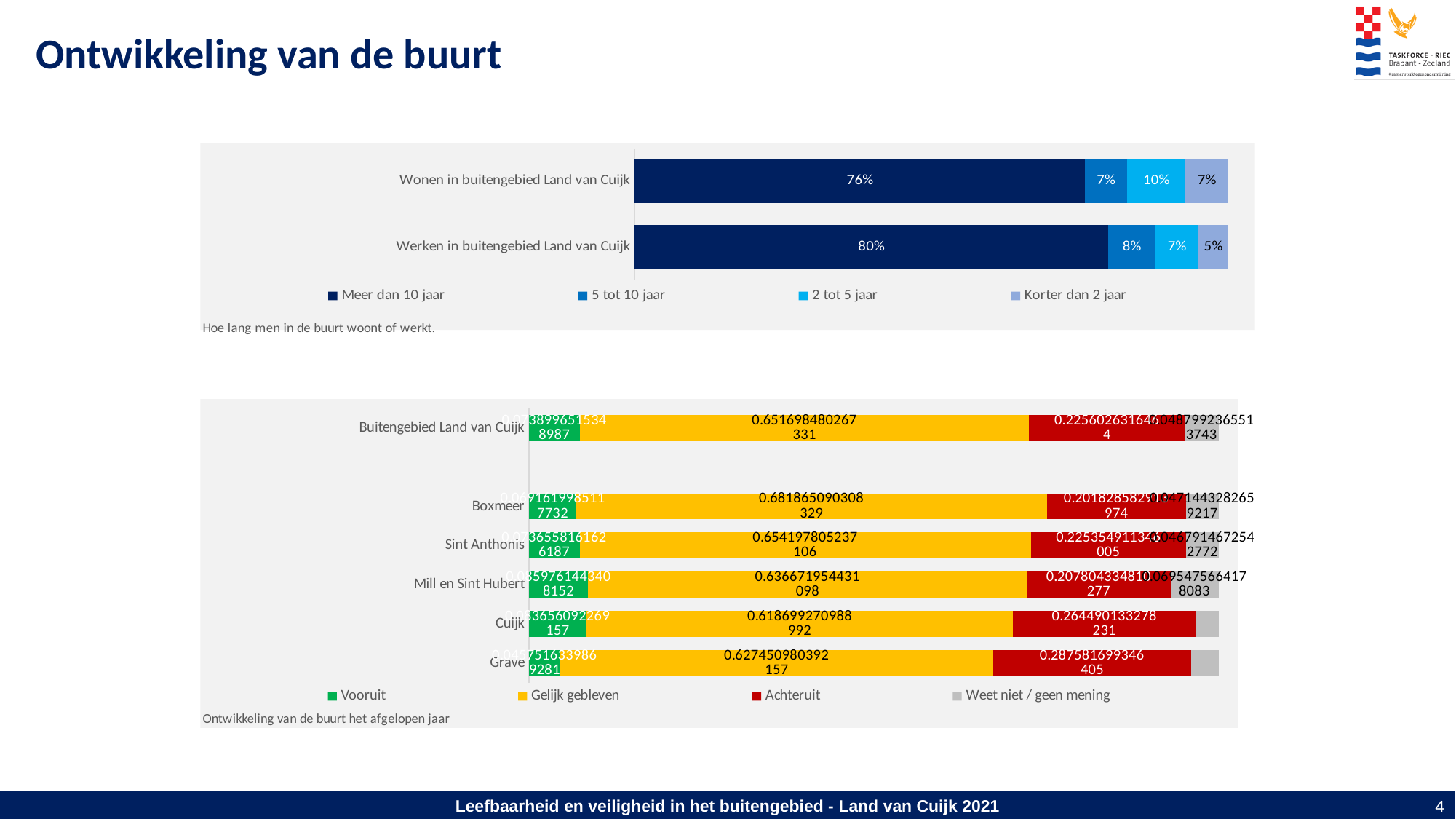
How many categories are shown in the bottom chart ('Ontwikkeling van de buurt het afgelopen jaar')? 6 In the top chart, what is the difference between the 'Meer dan 10 jaar' values for Werken and Wonen in buitengebied Land van Cuijk? 4% In the bottom chart, which series is shown in yellow according to the legend? Gelijk gebleven In the bottom chart, which category has the largest 'Achteruit' (red) segment? Grave How many series does the legend of the top chart list? 4 In the top chart, what is the 'Meer dan 10 jaar' value for 'Werken in buitengebied Land van Cuijk'? 80% In the top chart, what is the 'Korter dan 2 jaar' value for 'Werken in buitengebied Land van Cuijk'? 5% In the top chart, what is the '2 tot 5 jaar' value for 'Wonen in buitengebied Land van Cuijk'? 10% What type of chart is the top chart on the slide? Stacked bar chart In the top chart, what is the difference between the '2 tot 5 jaar' values for Wonen and Werken in buitengebied Land van Cuijk? 3% In the top chart, which category has the larger 'Meer dan 10 jaar' share: Wonen or Werken in buitengebied Land van Cuijk? Werken in buitengebied Land van Cuijk In the top chart, what percentage of those who live in the buitengebied Land van Cuijk have done so for more than 10 years (Meer dan 10 jaar)? 76%